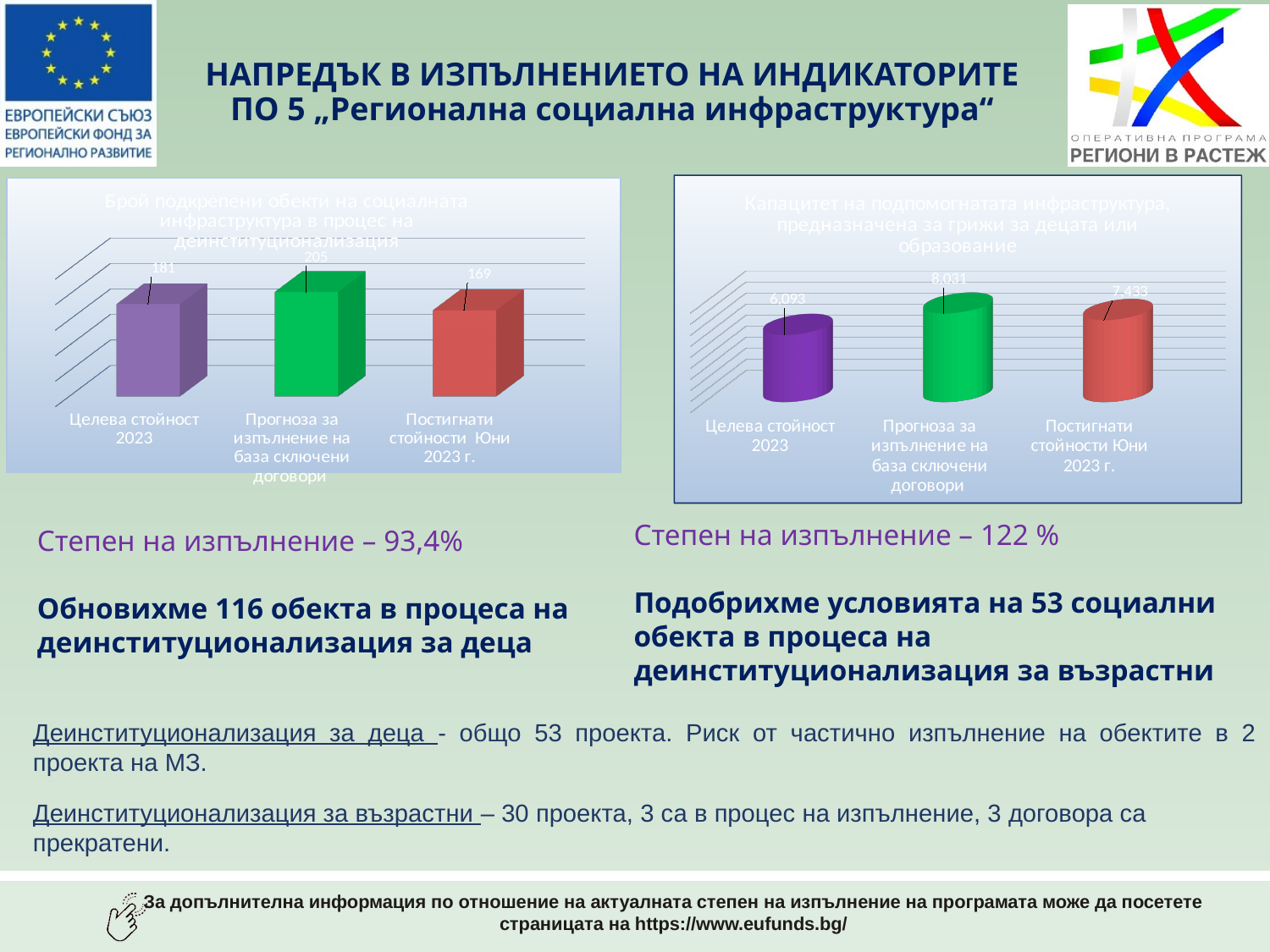
In the left chart (Брой подкрепени обекти на социалната инфраструктура в процес на деинституционализация), what is the value for Целева стойност 2023? 181 In the right chart, what is the value for Постигнати стойности Юни 2023 г.? 7,433 In the left chart, what is the value for Прогноза за изпълнение на база сключени договори? 205 How many categories does the right chart show? 3 In the left chart, which category has the lowest value? Постигнати стойности Юни 2023 г. In the right chart (Капацитет на подпомогнатата инфраструктура), what is the value for Целева стойност 2023? 6,093 In the right chart, what is the value for Прогноза за изпълнение на база сключени договори? 8,031 In the right chart, which is larger: Постигнати стойности Юни 2023 г. or Целева стойност 2023? Постигнати стойности Юни 2023 г. In the left chart, what is the difference between Прогноза за изпълнение на база сключени договори and Целева стойност 2023? 24 In the left chart, which category has the highest value? Прогноза за изпълнение на база сключени договори In the left chart, what is the value for Постигнати стойности Юни 2023 г.? 169 What kind of chart is the left chart? Bar chart